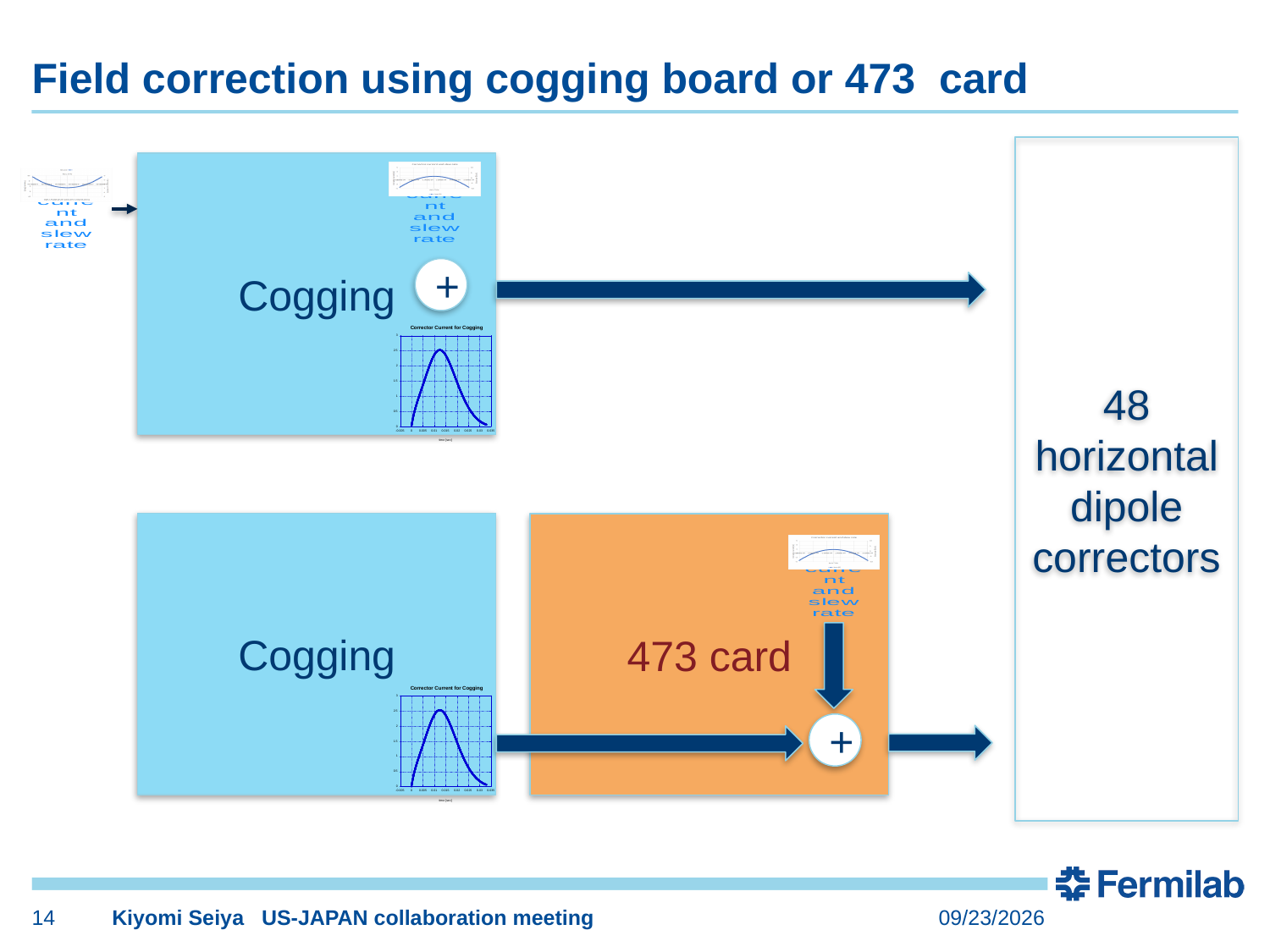
What kind of chart is the "Corrector Current for Cogging" chart in the upper Cogging box? line chart In the "Corrector Current for Cogging" chart, does the plotted value first rise and then fall, or first fall and then rise, along the x axis? rise then fall How many charts titled "Corrector Current for Cogging" appear on the slide? 2 What is the x-axis label of the "Corrector Current for Cogging" chart? time [sec] How many lines are plotted in the "Corrector Current for Cogging" chart in the lower Cogging box? 1 What is the title of the chart shown in the lower-right corner of the upper Cogging box? Corrector Current for Cogging